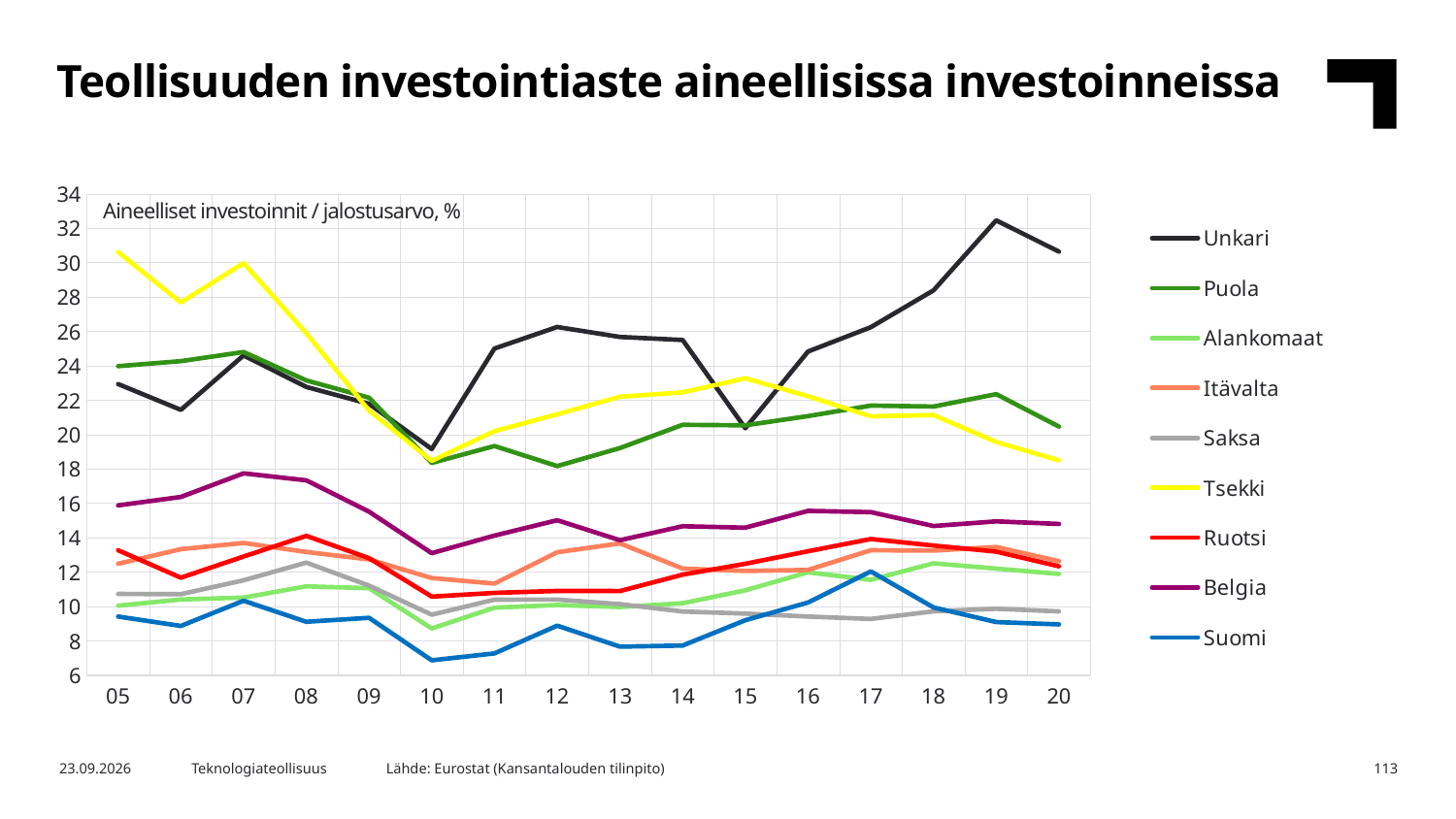
How many series does the legend list? 9 Which is larger in 2017, the value for Suomi or the value for Saksa? Suomi Which country has the highest value in 2005? Tsekki Is the value for Suomi in 2010 greater or less than 8? less Which country has the highest value in 2019? Unkari How many years are shown on the x axis? 16 Is the value for Belgia in 2007 greater or less than 16? greater Does the value for Tsekki rise or fall from 2015 to 2020? Fall What kind of chart is shown on the slide? Line chart Which country has the lowest value in 2010? Suomi Is the value for Unkari in 2019 greater or less than 30? greater What label is printed inside the top-left corner of the plot area? Aineelliset investoinnit / jalostusarvo, %